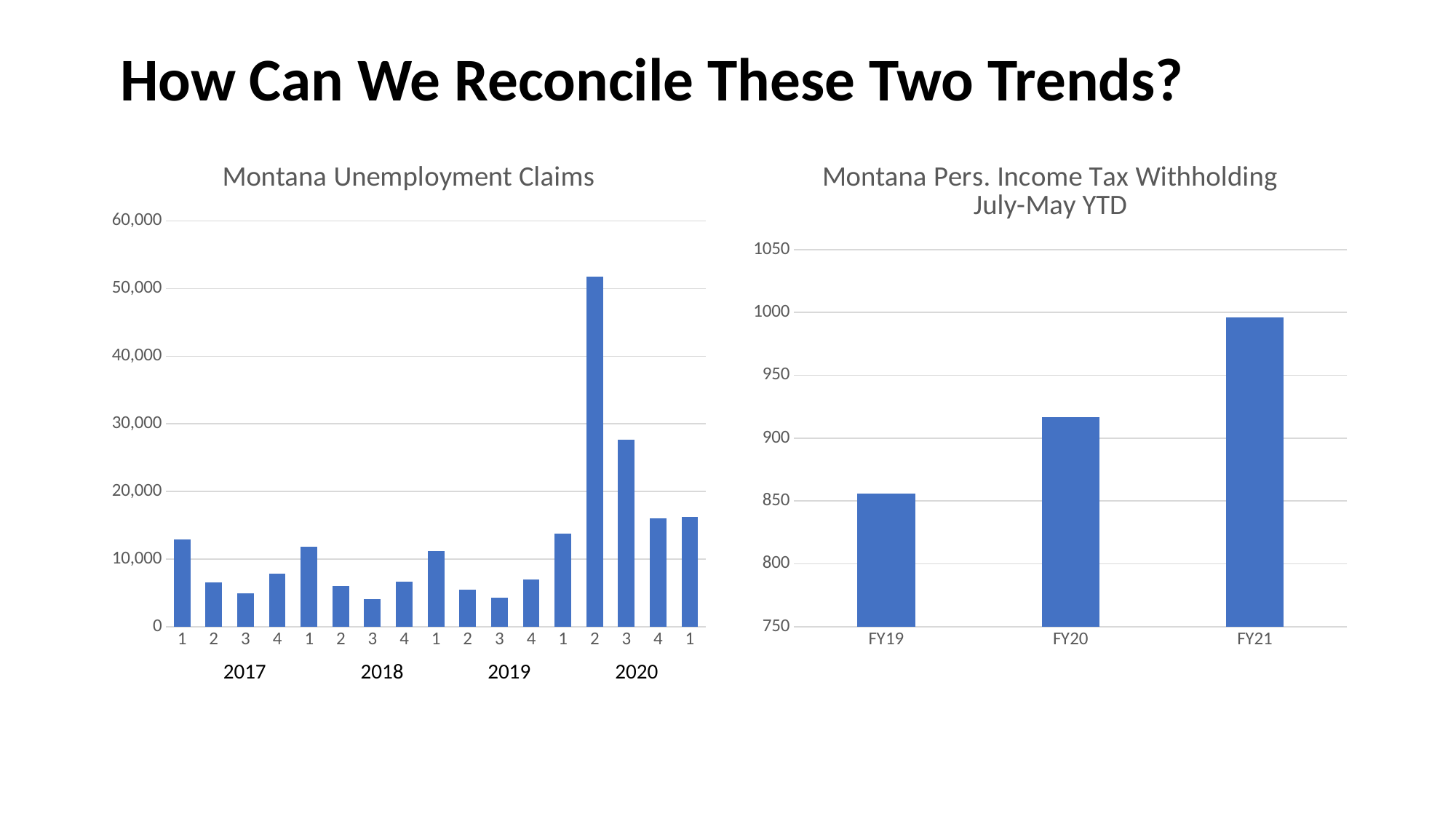
In the Montana Pers. Income Tax Withholding July-May YTD chart, is the value for FY19 greater or less than 900? less In the Montana Pers. Income Tax Withholding July-May YTD chart, do the values rise or fall from FY19 to FY21? Rise In the Montana Unemployment Claims chart, which quarter has the highest number of claims? Quarter 2 of 2020 In the Montana Unemployment Claims chart, which is larger: quarter 3 of 2019 or quarter 4 of 2019? Quarter 4 of 2019 What kind of chart is the Montana Unemployment Claims chart on the left? Bar chart In the Montana Unemployment Claims chart, how many bars are plotted? 17 In the Montana Pers. Income Tax Withholding July-May YTD chart, which fiscal year has the lowest value? FY19 In the Montana Pers. Income Tax Withholding July-May YTD chart, which fiscal year has the highest value? FY21 In the Montana Pers. Income Tax Withholding July-May YTD chart, is the value for FY21 greater or less than 950? greater In the Montana Unemployment Claims chart, is the value for quarter 1 of 2017 greater or less than 20,000? less In the Montana Pers. Income Tax Withholding July-May YTD chart, how many fiscal years are shown? 3